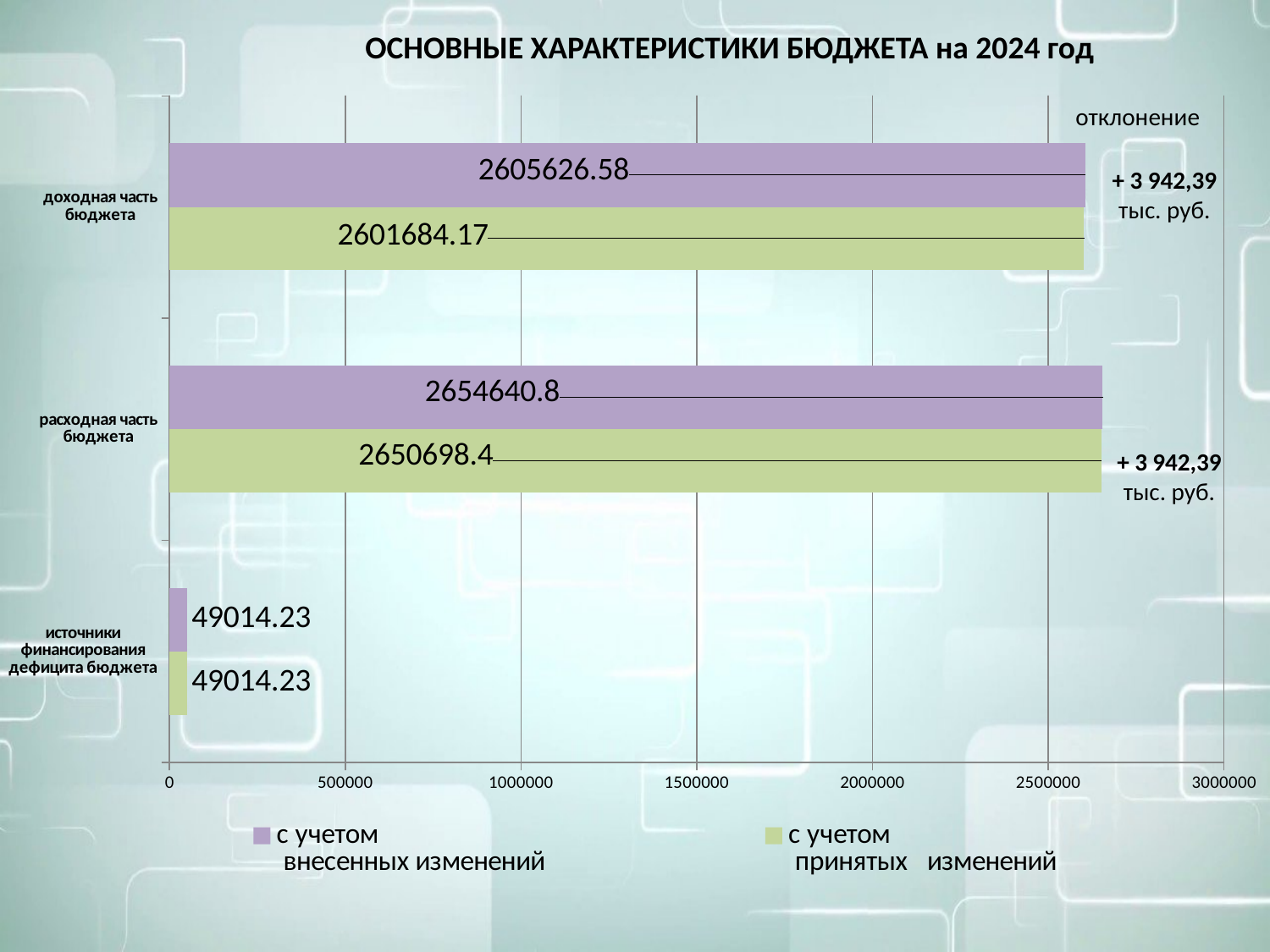
Which category has the highest value in the series с учетом внесенных изменений? расходная часть бюджета Is the value for источники финансирования дефицита бюджета in the series с учетом принятых изменений greater or less than 500000? less How many series does the legend list? 2 What is the value for источники финансирования дефицита бюджета in the series с учетом внесенных изменений? 49014.23 What is the value for доходная часть бюджета in the series с учетом принятых изменений? 2601684.17 What is the value for доходная часть бюджета in the series с учетом внесенных изменений? 2605626.58 Which category has the lowest values in the chart? источники финансирования дефицита бюджета What kind of chart is shown on the slide? bar chart What is the value for расходная часть бюджета in the series с учетом принятых изменений? 2650698.4 How many categories are shown on the chart? 3 Which is larger in the series с учетом принятых изменений: доходная часть бюджета or расходная часть бюджета? расходная часть бюджета What is the value for расходная часть бюджета in the series с учетом внесенных изменений? 2654640.8